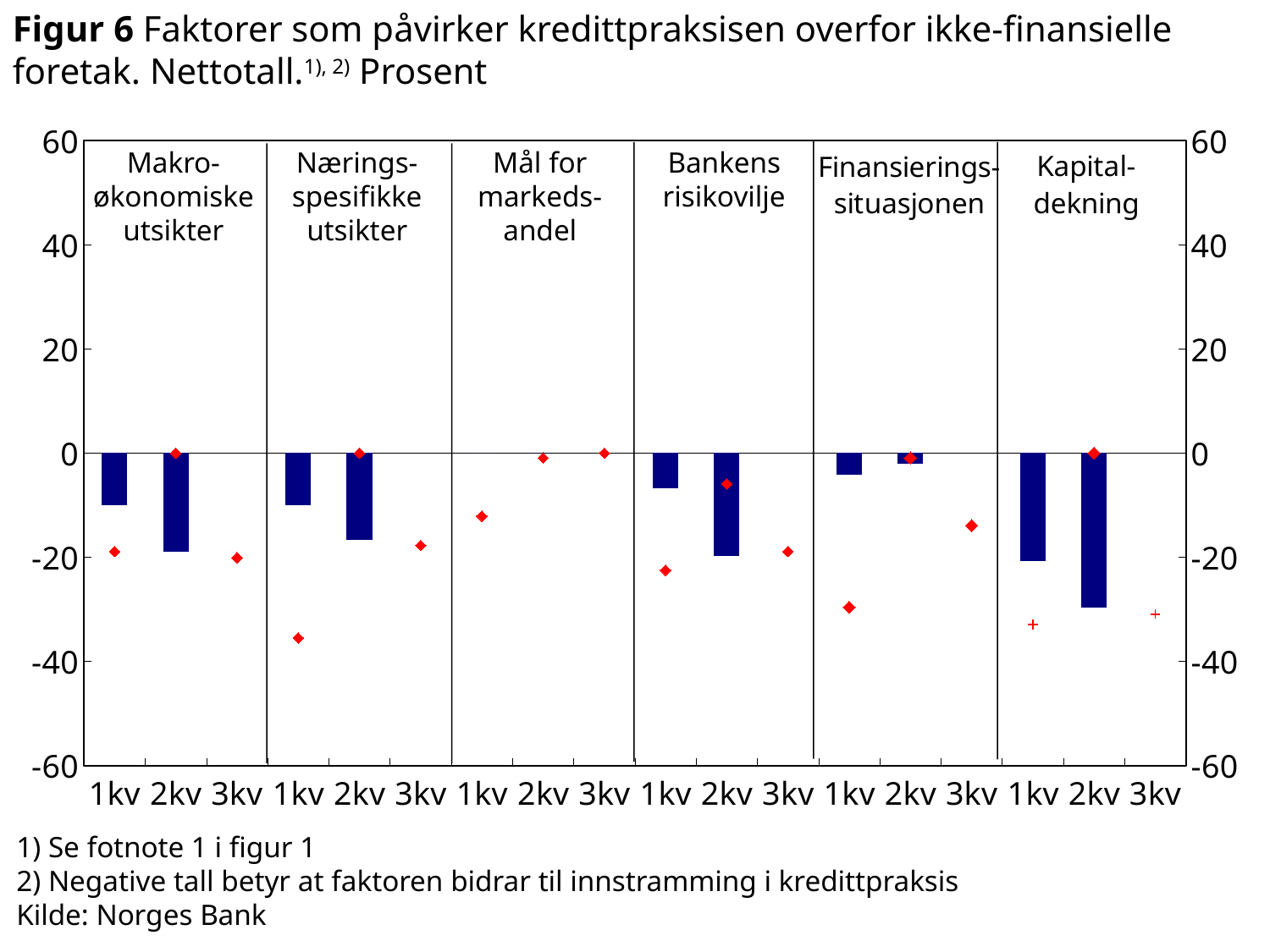
Is the 2kv bar in the 'Næringsspesifikke utsikter' panel greater or less than -20? greater In the 'Kapitaldekning' panel, do the bars rise or fall from 1kv to 2kv? fall Is the 1kv bar in the 'Makroøkonomiske utsikter' panel greater or less than -20? greater What is the maximum value shown on the y axis? 60 Which panel has the lowest (most negative) 2kv bar? Kapitaldekning Which panel shows no bars at all, only red markers? Mål for markedsandel How many quarters (kv) are shown on the x axis within each panel? 3 What kind of chart is shown in Figur 6? bar chart How many factor panels are shown in the chart? 6 Is the 2kv bar in the 'Kapitaldekning' panel greater or less than -20? less